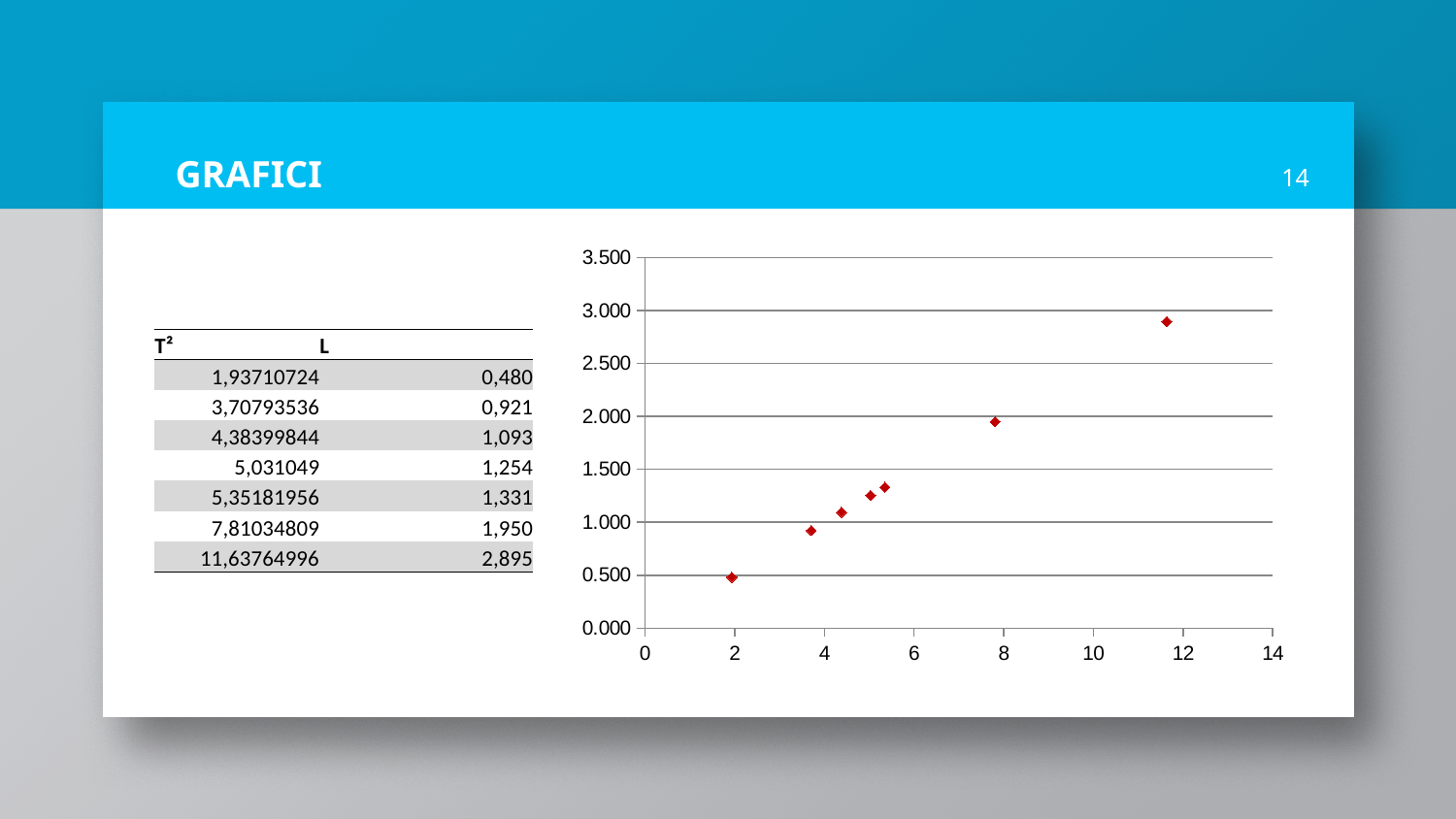
What is the highest value shown on the y axis of the chart? 3.500 What kind of chart is shown on the slide? scatter chart According to the table on the slide, what is the largest value of L? 2,895 Which point has the highest y value: the one near x = 8 or the one near x = 12? the one near x = 12 How many data points are plotted on the chart? 7 Is the y value of the point near x = 4 greater or less than 1.500? less Is the y value of the point near x = 8 greater or less than 1.500? greater According to the table on the slide, what is the smallest value of L? 0,480 Do the plotted values rise or fall as the x value increases? rise According to the table on the slide, what is the value of L when T² is 5,031049? 1,254 Is the y value of the leftmost point (near x = 2) greater or less than 1.000? less